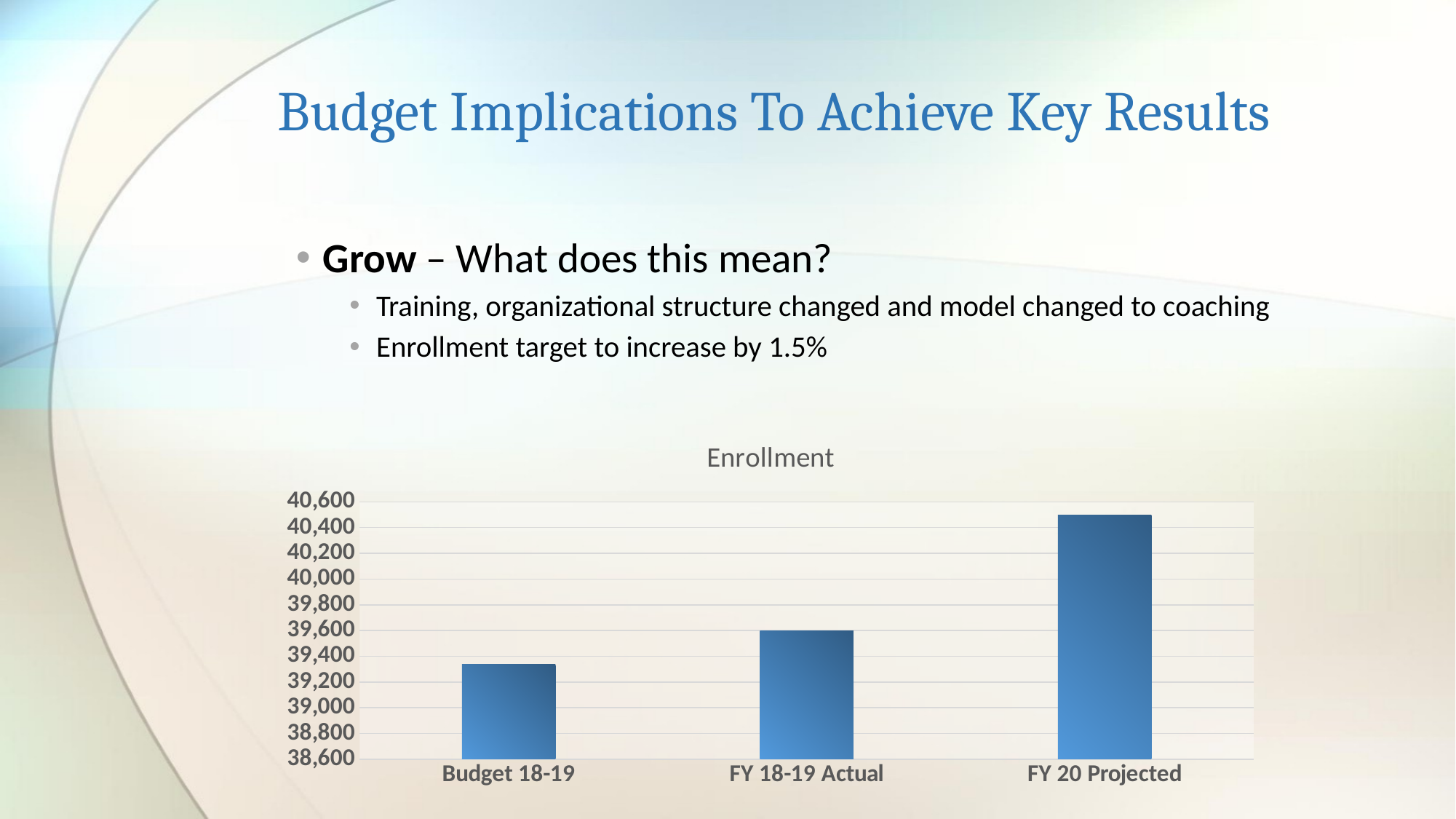
How many categories are shown on the x axis of the chart? 3 Which category has the lowest enrollment value? Budget 18-19 Which is larger, the value for FY 18-19 Actual or the value for Budget 18-19? FY 18-19 Actual Is the value for FY 18-19 Actual greater or less than 40,000? less What kind of chart is shown on the slide? bar chart Do the enrollment values rise or fall from left to right across the x axis? rise What is the title of the chart? Enrollment Is the value for Budget 18-19 greater or less than 39,200? greater Which category has the highest enrollment value? FY 20 Projected Is the value for Budget 18-19 greater or less than 39,400? less